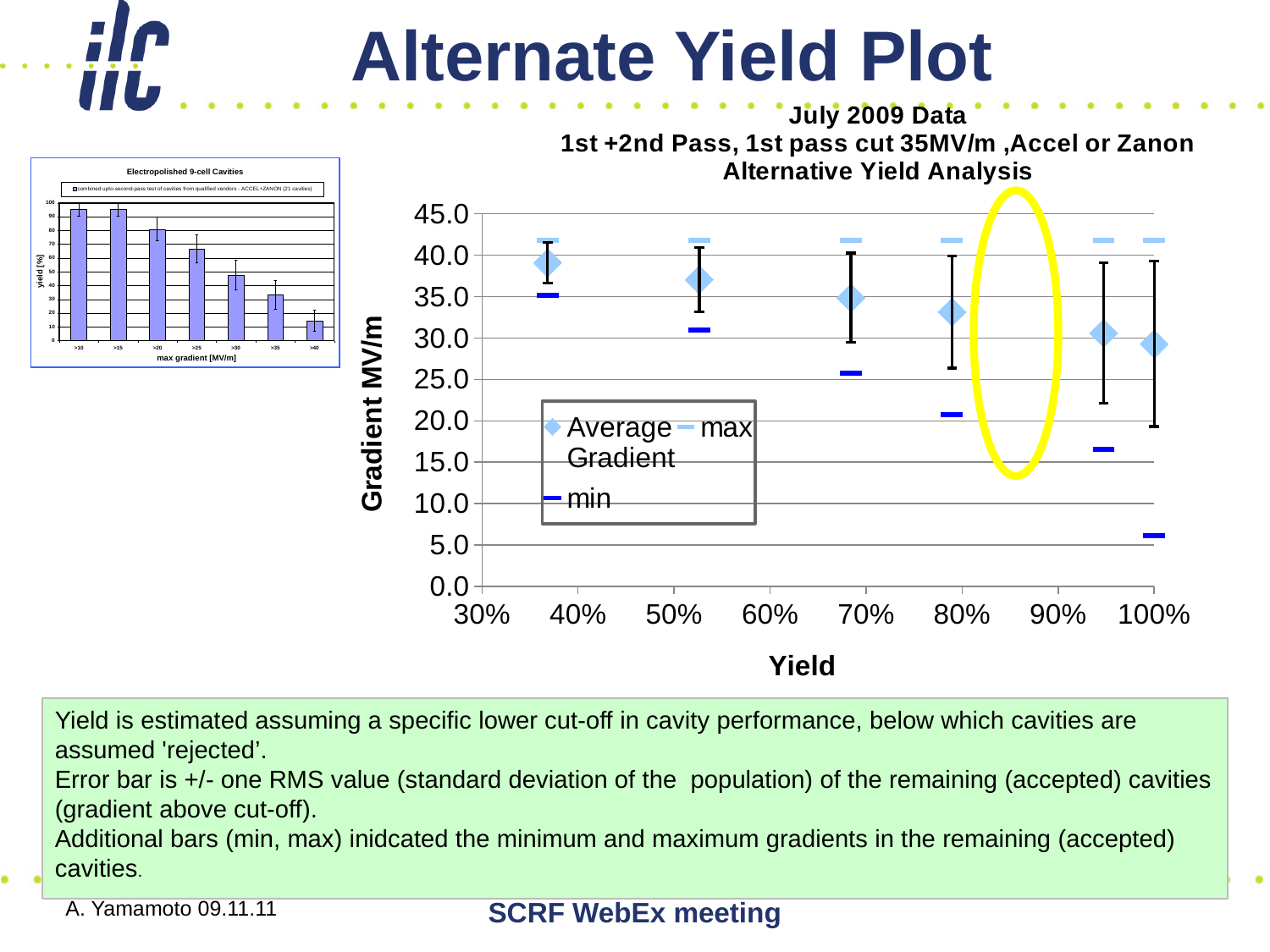
In the small 'Electropolished 9-cell Cavities' chart, how many categories are on the x axis? 7 In the small 'Electropolished 9-cell Cavities' chart, is the yield for >40 greater or less than 20? less What kind of chart is the small chart titled 'Electropolished 9-cell Cavities'? bar chart In the small 'Electropolished 9-cell Cavities' chart, which max gradient category has the lowest yield? >40 In the large 'Alternative Yield Analysis' chart, is the min value at 100% yield greater or less than 10.0? less What kind of chart is the large chart titled 'Alternative Yield Analysis'? scatter chart In the large 'Alternative Yield Analysis' chart, is the leftmost Average Gradient point (near 37% yield) greater or less than 35.0? greater In the large 'Alternative Yield Analysis' chart, how many series does the legend list? 3 In the large 'Alternative Yield Analysis' chart, at which Yield value is the min bar lowest? 100% In the small 'Electropolished 9-cell Cavities' chart, which has the higher yield, >25 or >30? >25 In the large 'Alternative Yield Analysis' chart, does the Average Gradient rise or fall as Yield increases along the x axis? fall In the large 'Alternative Yield Analysis' chart, what is the y-axis title? Gradient MV/m